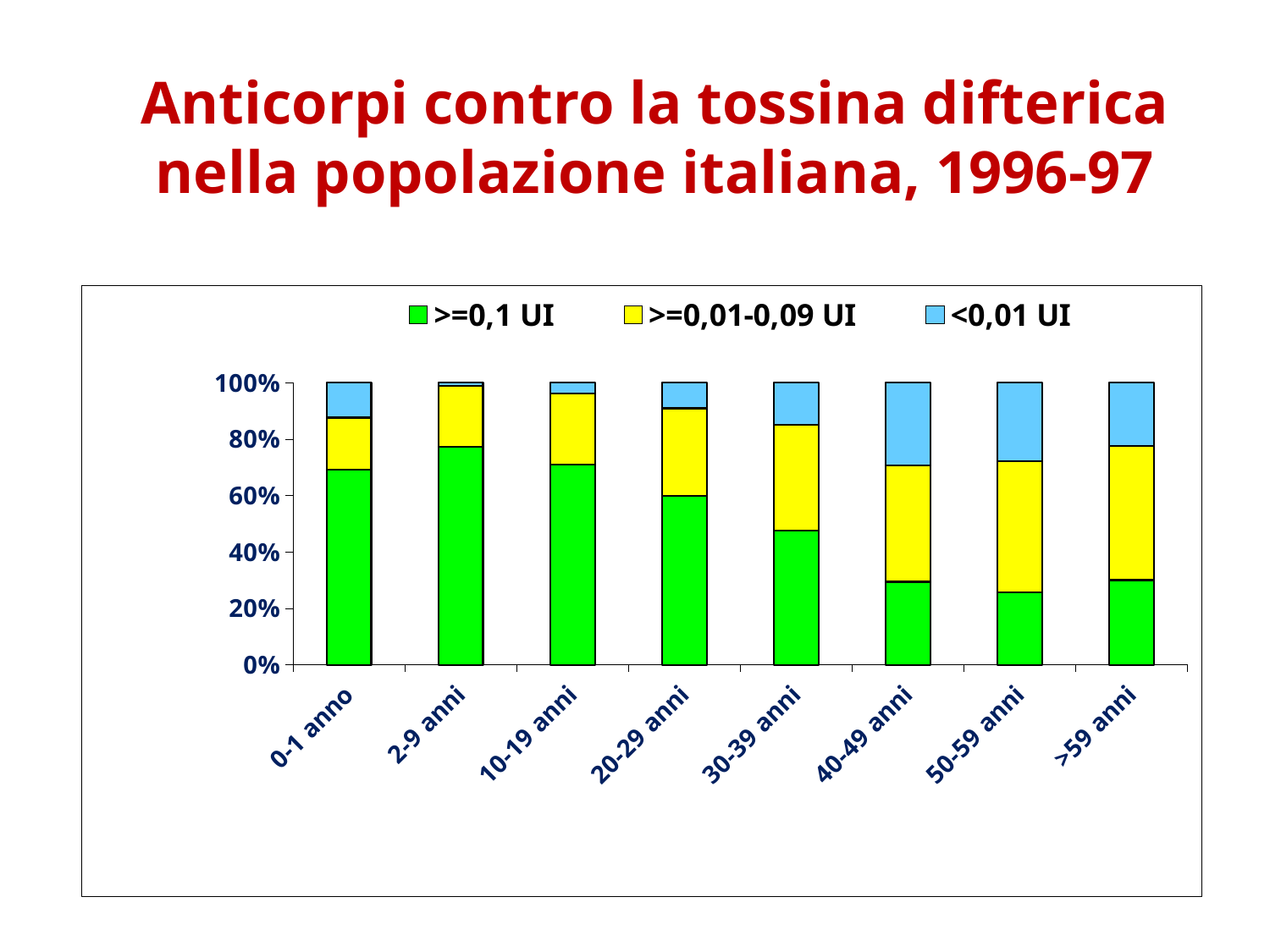
How many age groups are shown on the x axis? 8 What is the total of the stacked bar for 0-1 anno? 100% Is the >=0,1 UI share for 30-39 anni greater or less than 60%? less Which age group has the highest share of >=0,1 UI (green)? 2-9 anni Which age group has the smallest share of <0,01 UI (light blue)? 2-9 anni Which has a larger >=0,1 UI share, 10-19 anni or 50-59 anni? 10-19 anni What kind of chart is shown on the slide? Stacked bar chart How many series does the legend list? 3 Is the >=0,1 UI share for 40-49 anni greater or less than 40%? less Is the >=0,1 UI share for 0-1 anno greater or less than 60%? greater Does the >=0,1 UI share generally rise or fall from the 2-9 anni group to the older age groups? fall Which has a larger >=0,1 UI share, 2-9 anni or 30-39 anni? 2-9 anni